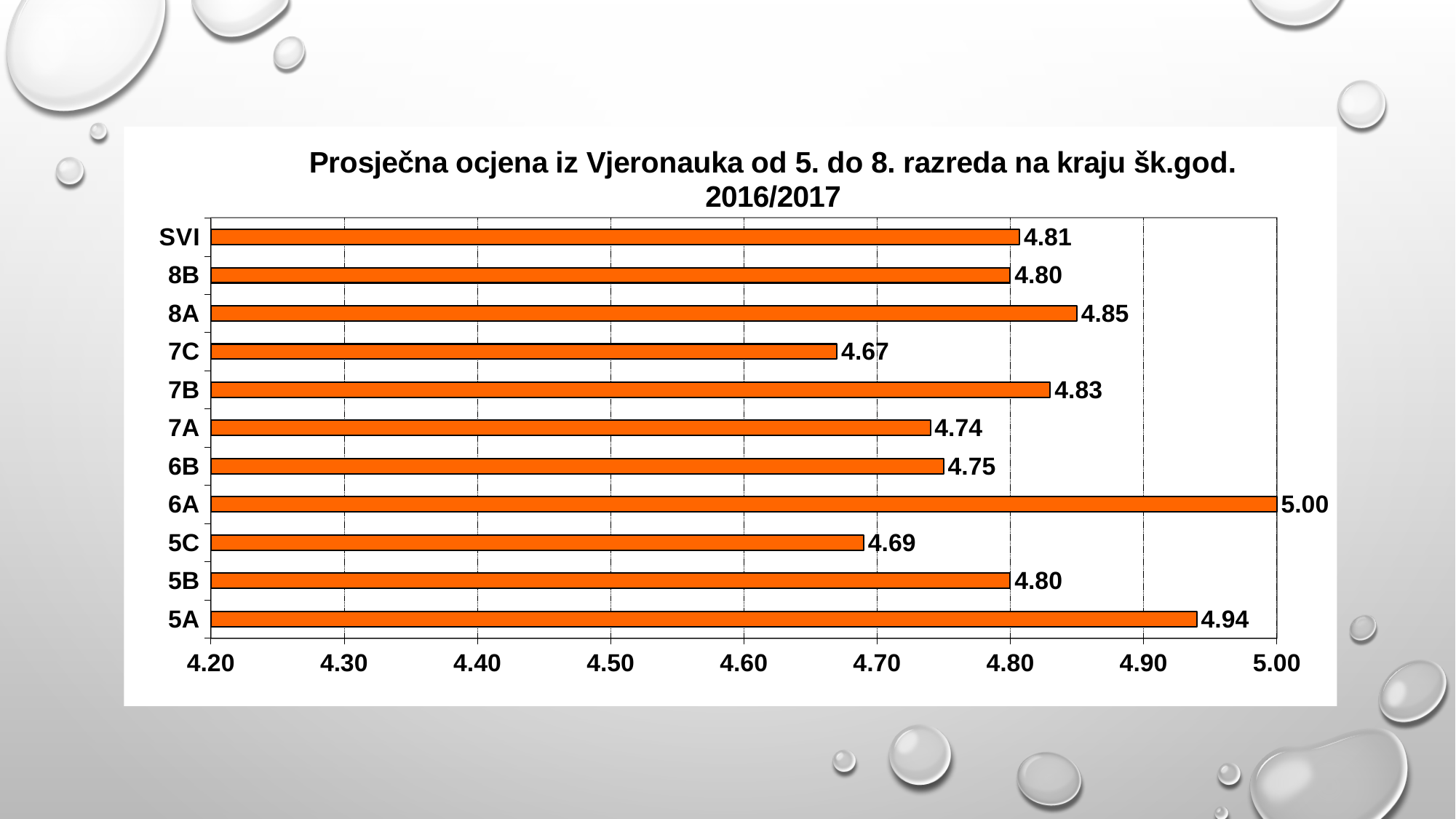
What is the value for 6A? 5.00 Which is larger, the value for 8A or the value for 7A? 8A What is the value for SVI? 4.81 Which category has the lowest value? 7C What is the value for 7C? 4.67 How many categories are shown on the chart? 11 Which category has the highest value? 6A What is the difference between the values for 6A and 7C? 0.33 What kind of chart is this? bar chart Is the value for 7B greater or less than 4.80? greater What is the title of the chart? Prosječna ocjena iz Vjeronauka od 5. do 8. razreda na kraju šk.god. 2016/2017 What is the difference between the values for 5A and 5C? 0.25